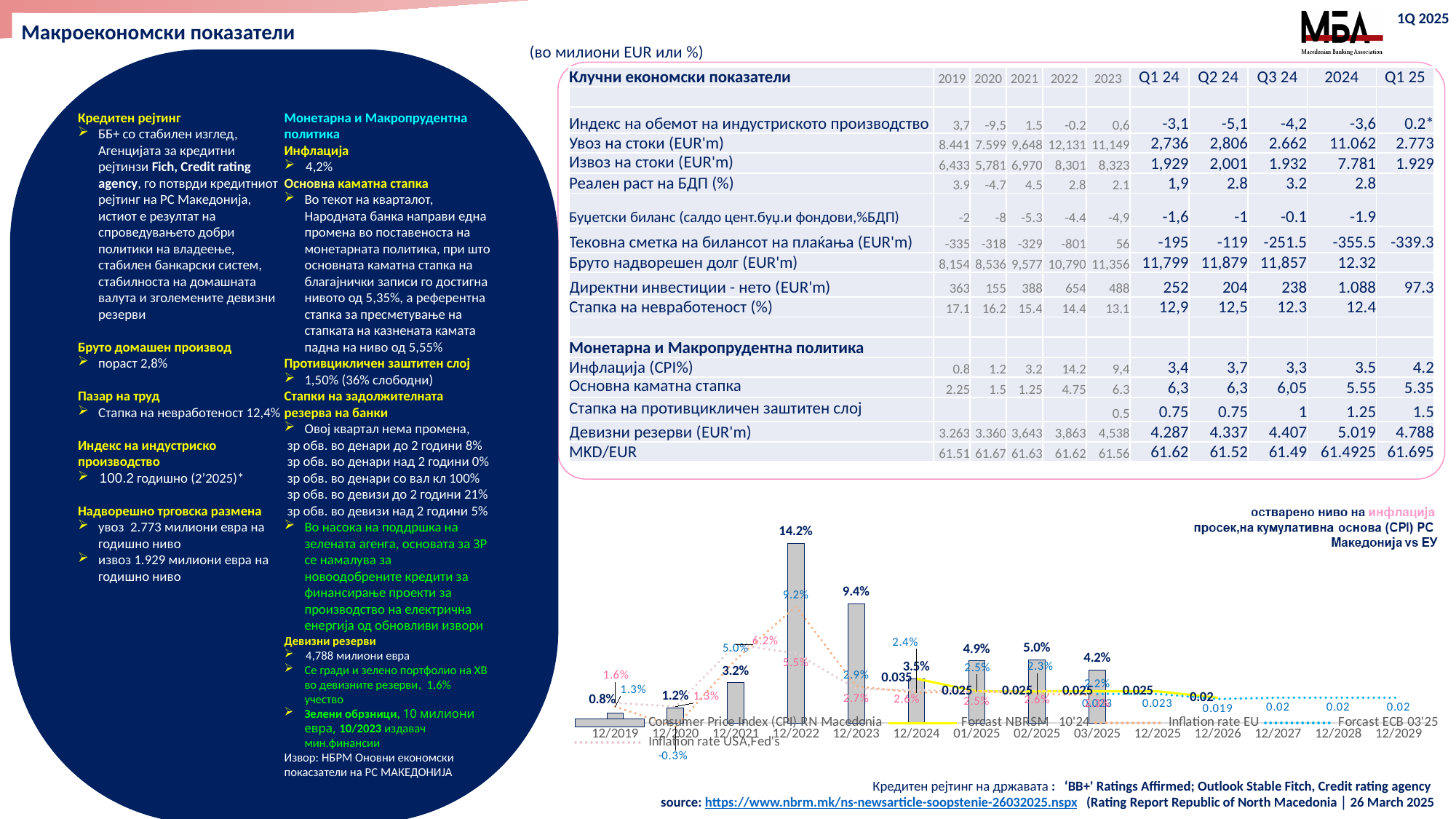
In the inflation chart at the bottom of the slide, what is the Forecast NBRSM value at 12/2026? 0.02 In the inflation chart at the bottom of the slide, which period has the highest CPI bar for RN Macedonia? 12/2022 In the inflation chart at the bottom of the slide, what is the difference between the CPI bars for 12/2022 and 12/2023? 4.8% In the inflation chart at the bottom of the slide, what is the Forecast ECB value at 12/2026? 0.019 In the inflation chart at the bottom of the slide, how many CPI bars for RN Macedonia are plotted? 9 In the inflation chart at the bottom of the slide, how many series does the legend list? 5 In the inflation chart at the bottom of the slide, what is the CPI value for RN Macedonia at 12/2022? 14.2% What kind of chart is shown at the bottom of the slide? Bar chart with line series In the inflation chart at the bottom of the slide, do the CPI bars for RN Macedonia rise or fall from 12/2022 to 12/2024? Fall In the inflation chart at the bottom of the slide, which period has the lowest CPI bar for RN Macedonia? 12/2019 In the inflation chart at the bottom of the slide, which CPI bar is larger: 01/2025 or 02/2025? 02/2025 In the inflation chart at the bottom of the slide, what is the CPI value for RN Macedonia at 03/2025? 4.2%